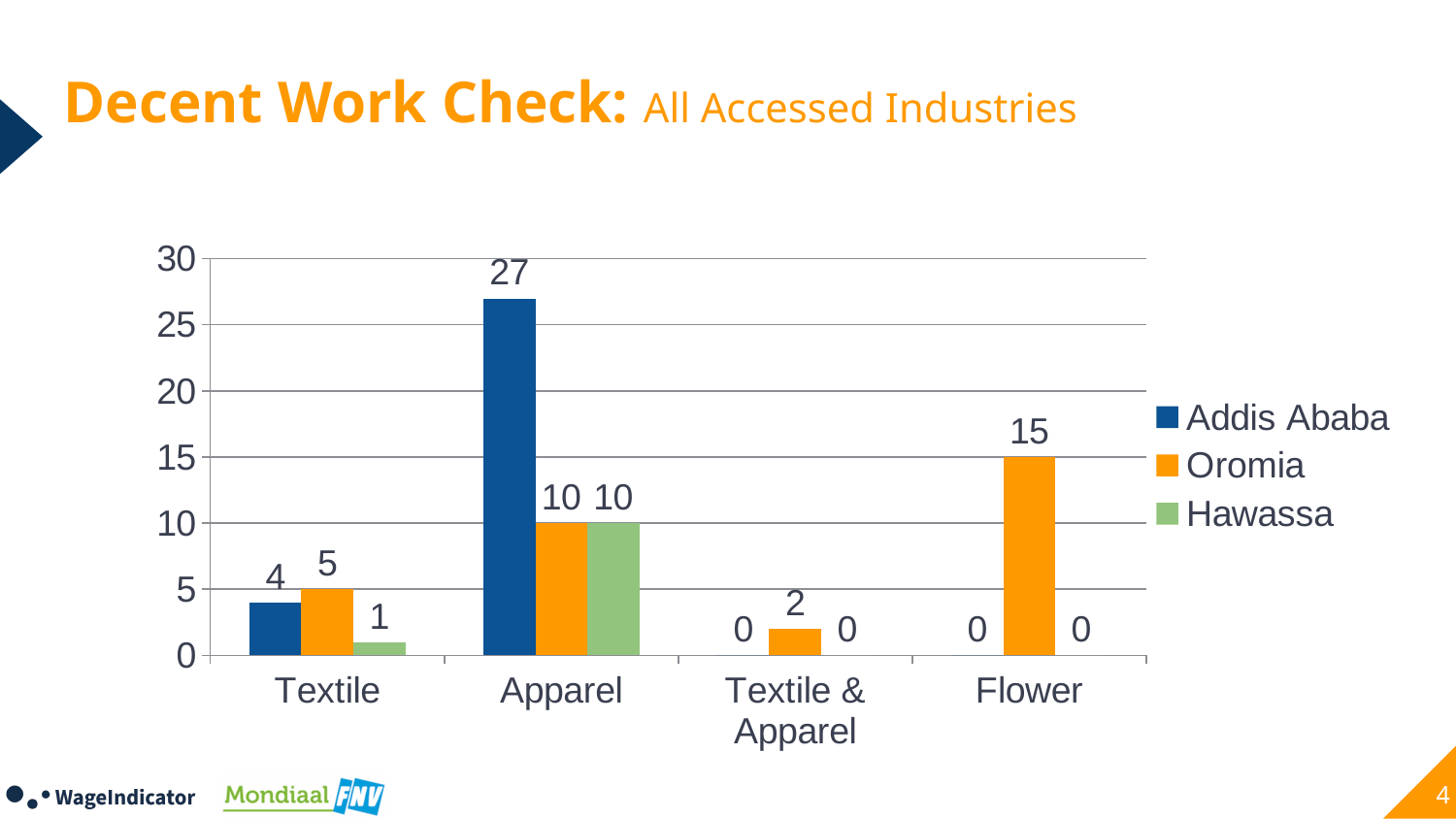
Which series is shown in orange in the legend? Oromia How many series does the legend list? 3 What is the value for Addis Ababa in the Apparel category? 27 Which category has the highest value for Addis Ababa? Apparel Which category has the lowest value for Oromia? Textile & Apparel What kind of chart is shown on the slide? Bar chart How many categories are shown on the x axis? 4 Which is larger in the Textile category, the Addis Ababa value or the Oromia value? Oromia What is the value for Hawassa in the Textile category? 1 What is the difference between the Addis Ababa and Oromia values in the Apparel category? 17 What is the value for Oromia in the Textile & Apparel category? 2 What is the value for Oromia in the Flower category? 15